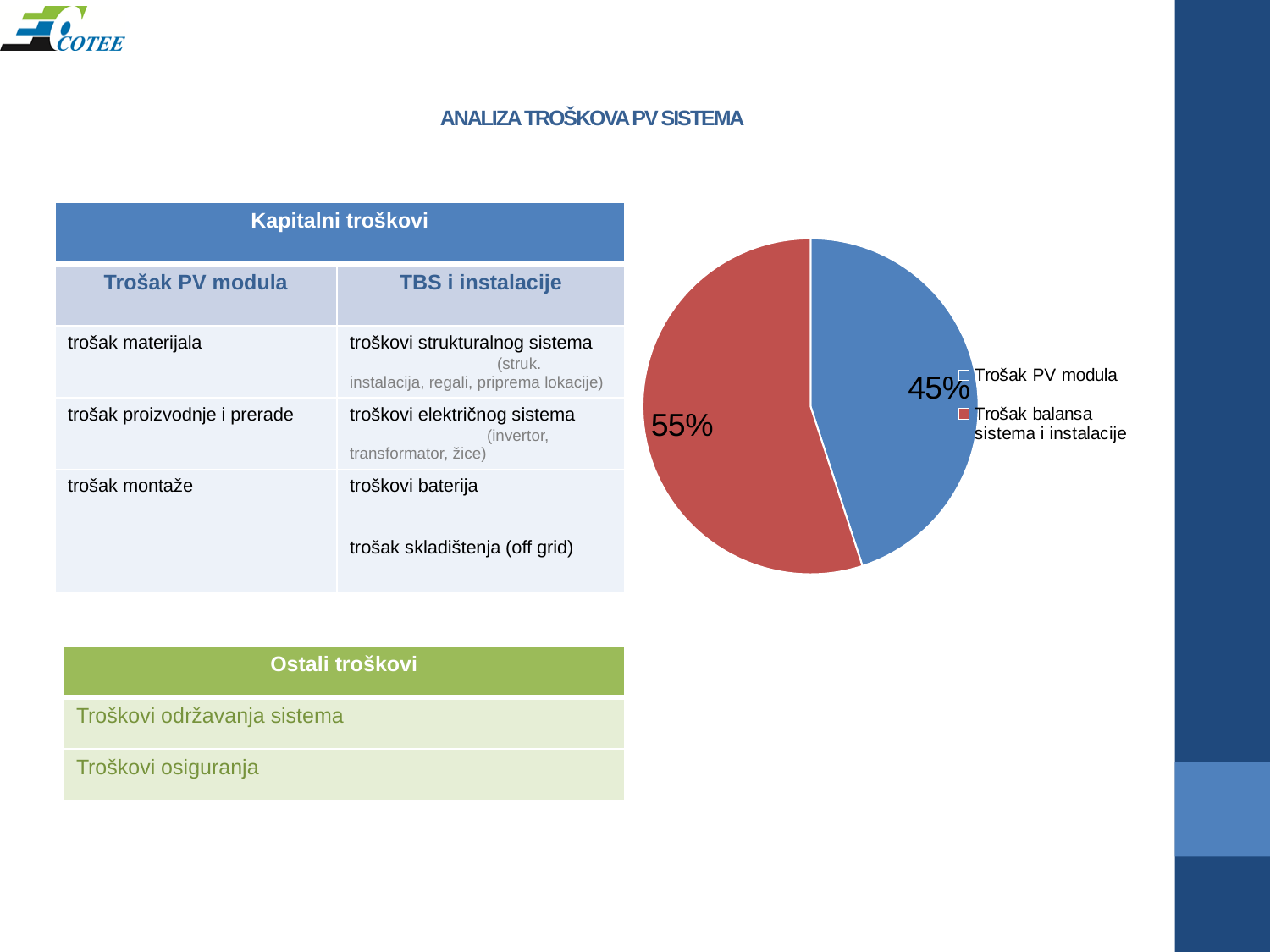
What is the difference in percentage points between Trošak balansa sistema i instalacije and Trošak PV modula? 10 What share of the pie does Trošak PV modula have? 45% Which slice of the pie is the largest? Trošak balansa sistema i instalacije Is the share for Trošak PV modula greater or less than 50%? less How many slices does the pie chart have? 2 What colour is the Trošak PV modula slice in the pie chart? blue What colour is the Trošak balansa sistema i instalacije slice in the pie chart? red Which slice of the pie is the smallest? Trošak PV modula What kind of chart is shown on the slide? pie chart Which is larger, Trošak PV modula or Trošak balansa sistema i instalacije? Trošak balansa sistema i instalacije What share of the pie does Trošak balansa sistema i instalacije have? 55% How many entries does the legend of the pie chart list? 2